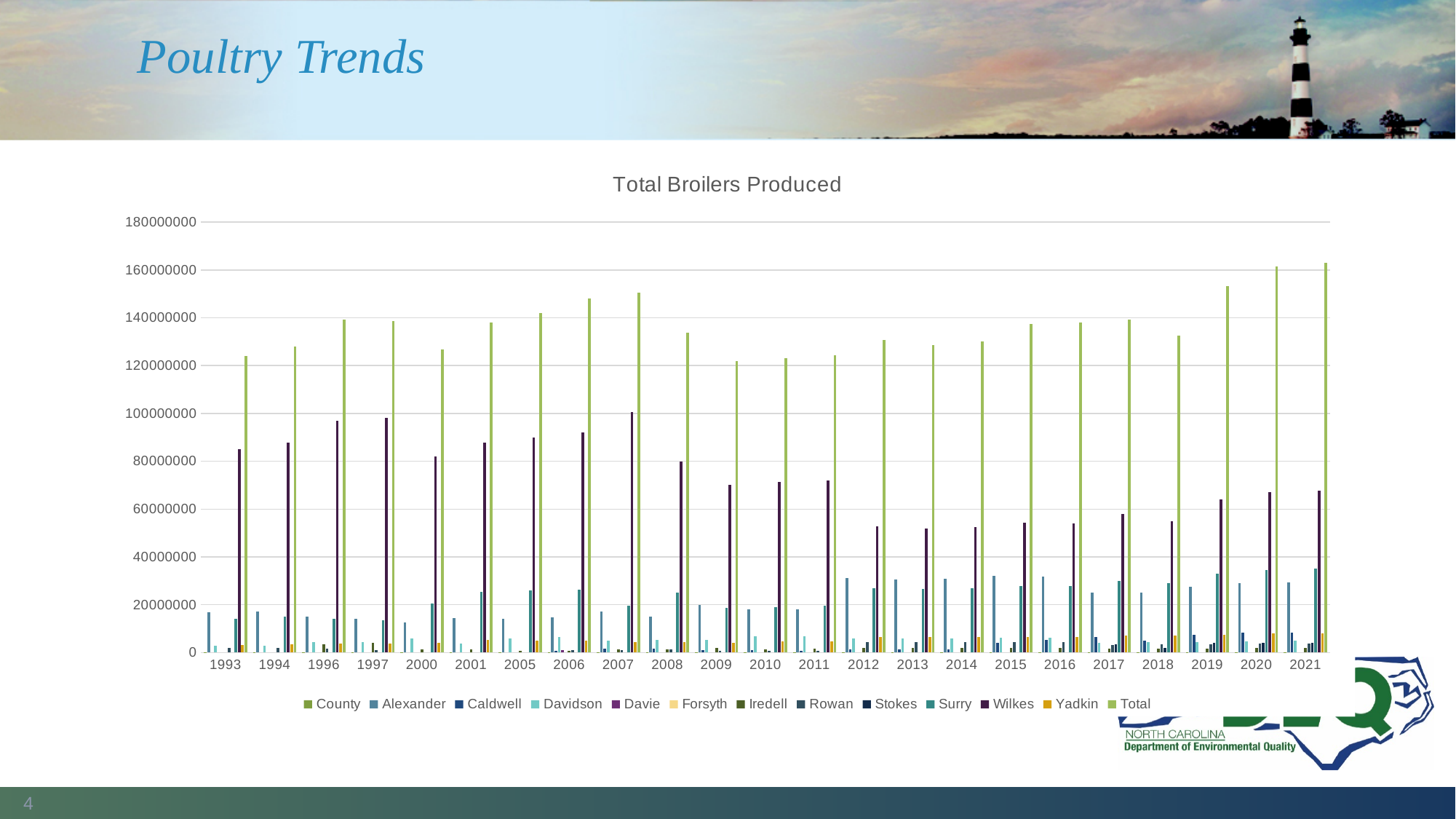
Is the value for Wilkes in 1993 greater or less than 80000000? greater How many series does the legend list? 13 Which is larger, the Total value for 2021 or the Total value for 2009? 2021 Is the value for Wilkes in 2013 greater or less than 60000000? less What is the title of the chart? Total Broilers Produced Is the value of the Total series for 2009 greater or less than 140000000? less Which is larger, the Wilkes value for 1993 or the Wilkes value for 2021? 1993 Does the Wilkes series generally rise or fall from 1993 to 2021? fall How many years are shown along the x axis? 23 What kind of chart is shown on the slide? bar chart